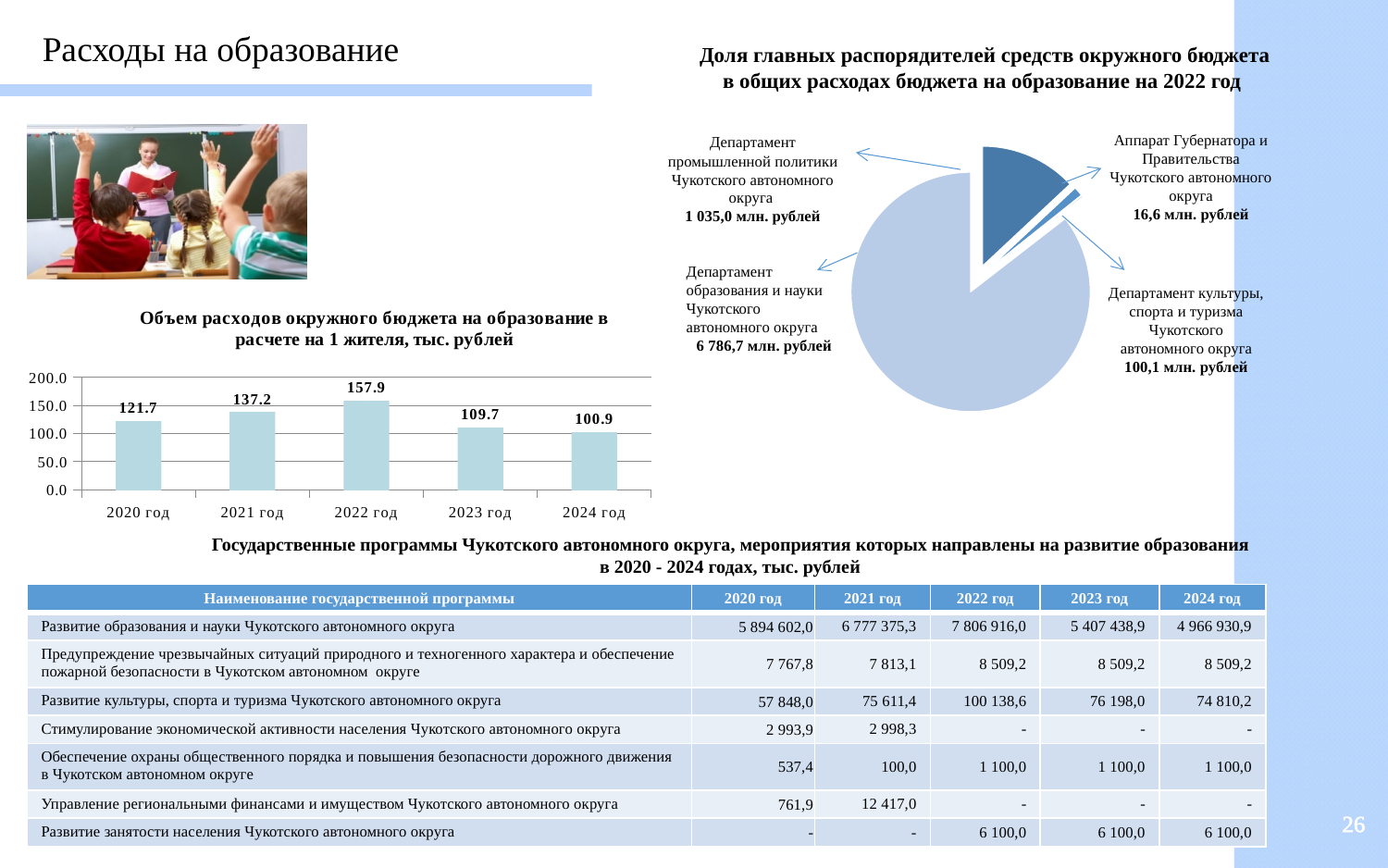
On the bar chart 'Объем расходов окружного бюджета на образование в расчете на 1 жителя', how many years are shown? 5 On the bar chart 'Объем расходов окружного бюджета на образование в расчете на 1 жителя', which year has the lowest value? 2024 год On the bar chart 'Объем расходов окружного бюджета на образование в расчете на 1 жителя', what is the value for 2022 год? 157.9 On the pie chart 'Доля главных распорядителей средств окружного бюджета в общих расходах бюджета на образование на 2022 год', what is the value for Департамент образования и науки Чукотского автономного округа? 6 786,7 млн. рублей On the bar chart 'Объем расходов окружного бюджета на образование в расчете на 1 жителя', which year has the highest value? 2022 год On the bar chart 'Объем расходов окружного бюджета на образование в расчете на 1 жителя', do the values rise or fall from 2022 год to 2024 год? fall On the pie chart 'Доля главных распорядителей средств окружного бюджета в общих расходах бюджета на образование на 2022 год', which slice is the smallest? Аппарат Губернатора и Правительства Чукотского автономного округа On the bar chart 'Объем расходов окружного бюджета на образование в расчете на 1 жителя', which is larger: the value for 2020 год or 2021 год? 2021 год On the bar chart 'Объем расходов окружного бюджета на образование в расчете на 1 жителя', what is the value for 2024 год? 100.9 What kind of chart is 'Объем расходов окружного бюджета на образование в расчете на 1 жителя'? bar chart What kind of chart is 'Доля главных распорядителей средств окружного бюджета в общих расходах бюджета на образование на 2022 год'? pie chart On the bar chart 'Объем расходов окружного бюджета на образование в расчете на 1 жителя', what is the difference between the values for 2022 год and 2023 год? 48.2